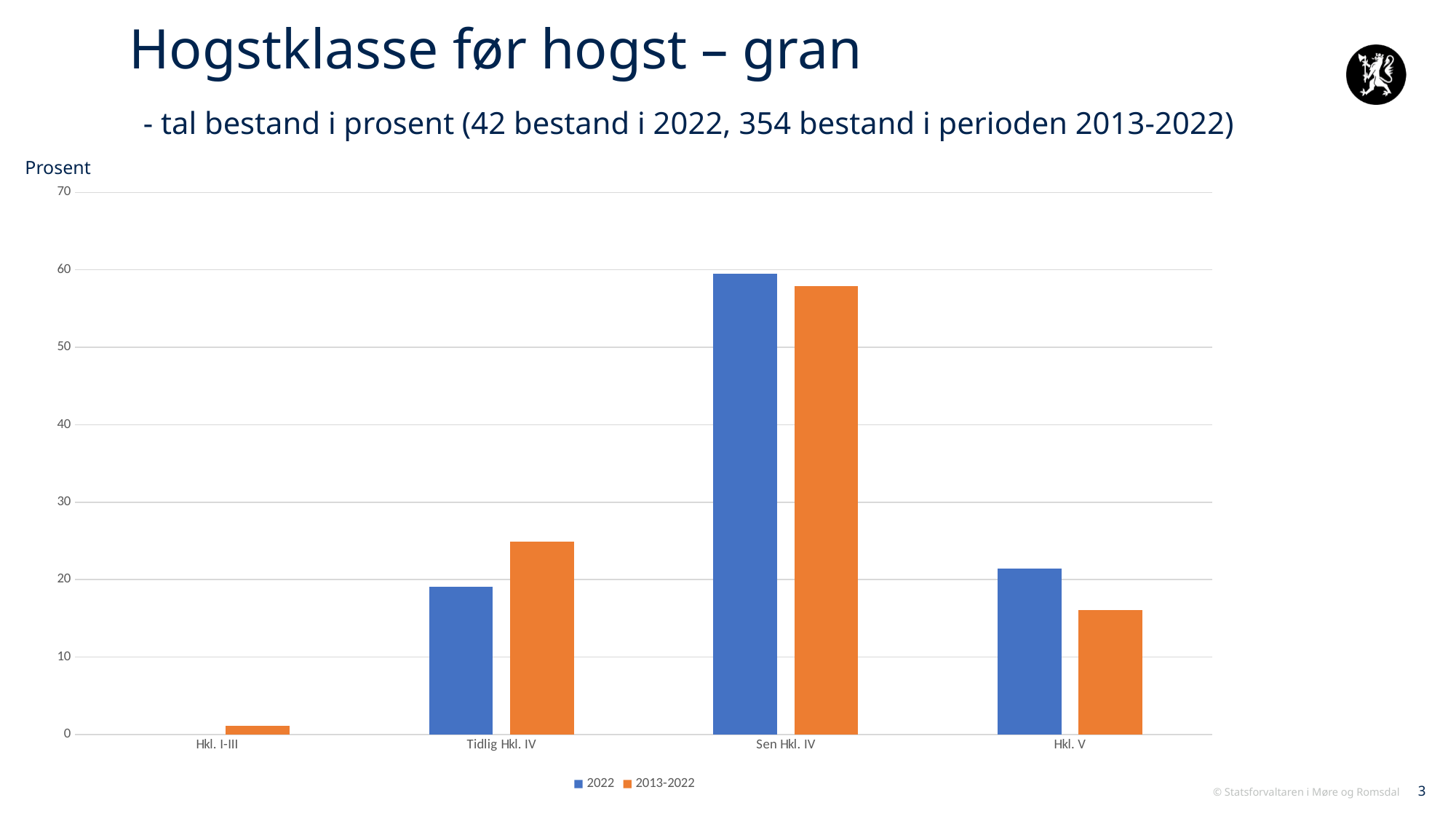
Which category has the highest value for the 2013-2022 series? Sen Hkl. IV What kind of chart is shown on the slide? Bar chart For Tidlig Hkl. IV, which series has the larger value, 2022 or 2013-2022? 2013-2022 Is the value for Hkl. V in 2013-2022 greater or less than 20? less Is the value for Tidlig Hkl. IV in 2022 greater or less than 20? less Which category has the highest value for the 2022 series? Sen Hkl. IV For Hkl. V, which series has the larger value, 2022 or 2013-2022? 2022 How many categories are shown on the x axis? 4 Which category has the lowest value for the 2013-2022 series? Hkl. I-III What is the label on the vertical axis of the chart? Prosent How many series does the legend list? 2 Is the value for Sen Hkl. IV in 2022 greater or less than 50? greater